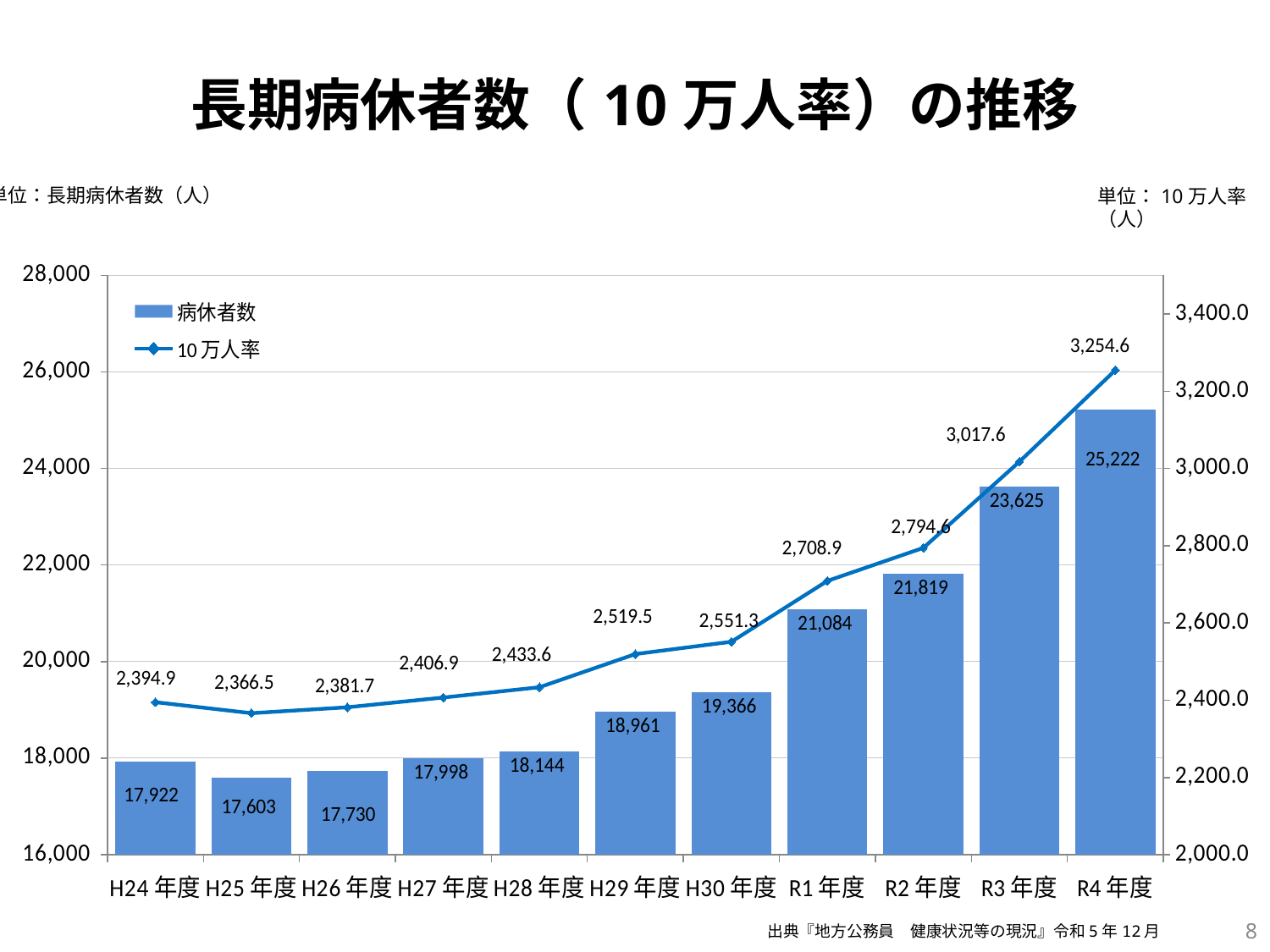
What kind of chart is this? Combined bar and line chart Which fiscal year has the lowest 病休者数? H25 年度 What is the difference in 病休者数 between R4 年度 and R3 年度? 1,597 What is the difference in 10 万人率 between R4 年度 and H24 年度? 859.7 What is the 病休者数 value for R4 年度? 25,222 Which is larger, the 10 万人率 for H24 年度 or for H26 年度? H24 年度 What is the 病休者数 value for H29 年度? 18,961 How many series does the legend list? 2 Do the 病休者数 values generally rise or fall from H26 年度 to R4 年度? Rise Which fiscal year has the highest 10 万人率? R4 年度 How many fiscal years are shown on the x axis? 11 What is the 10 万人率 value for H28 年度? 2,433.6